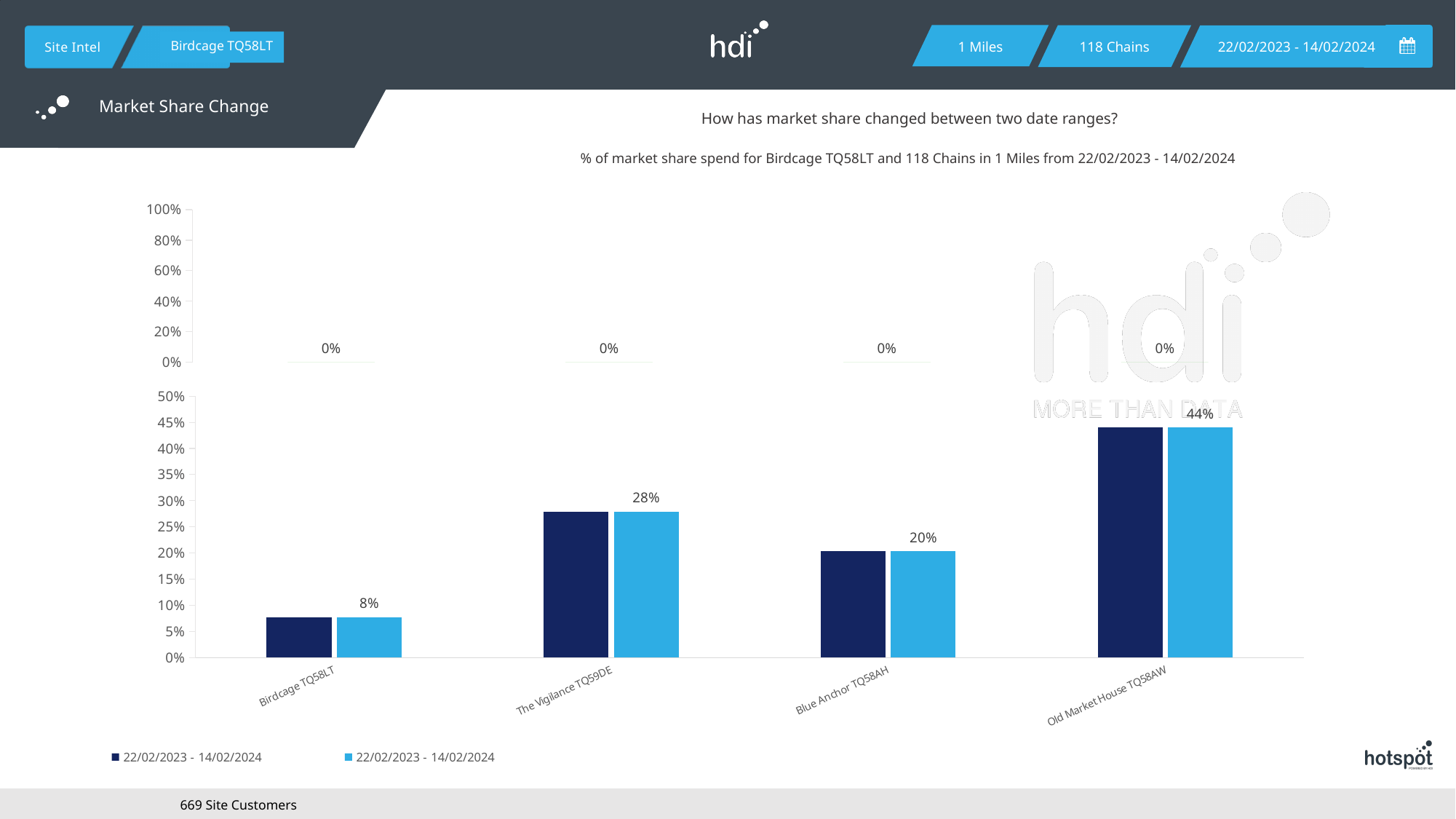
In the bottom chart, what is the difference between the market share of Old Market House TQ58AW and The Vigilance TQ59DE? 16% In the bottom chart, which category has the highest market share? Old Market House TQ58AW In the bottom chart, what is the market share value shown for Blue Anchor TQ58AH? 20% In the bottom chart, which category has the lowest market share? Birdcage TQ58LT What kind of chart is the bottom chart? Bar chart In the bottom chart, what is the market share value shown for The Vigilance TQ59DE? 28% How many categories are shown on the x axis of the bottom chart? 4 In the bottom chart, what is the market share value shown for Old Market House TQ58AW? 44% How many series does the legend of the bottom chart list? 2 In the bottom chart, which has a larger market share, The Vigilance TQ59DE or Blue Anchor TQ58AH? The Vigilance TQ59DE In the bottom chart, what is the market share value shown for Birdcage TQ58LT? 8%